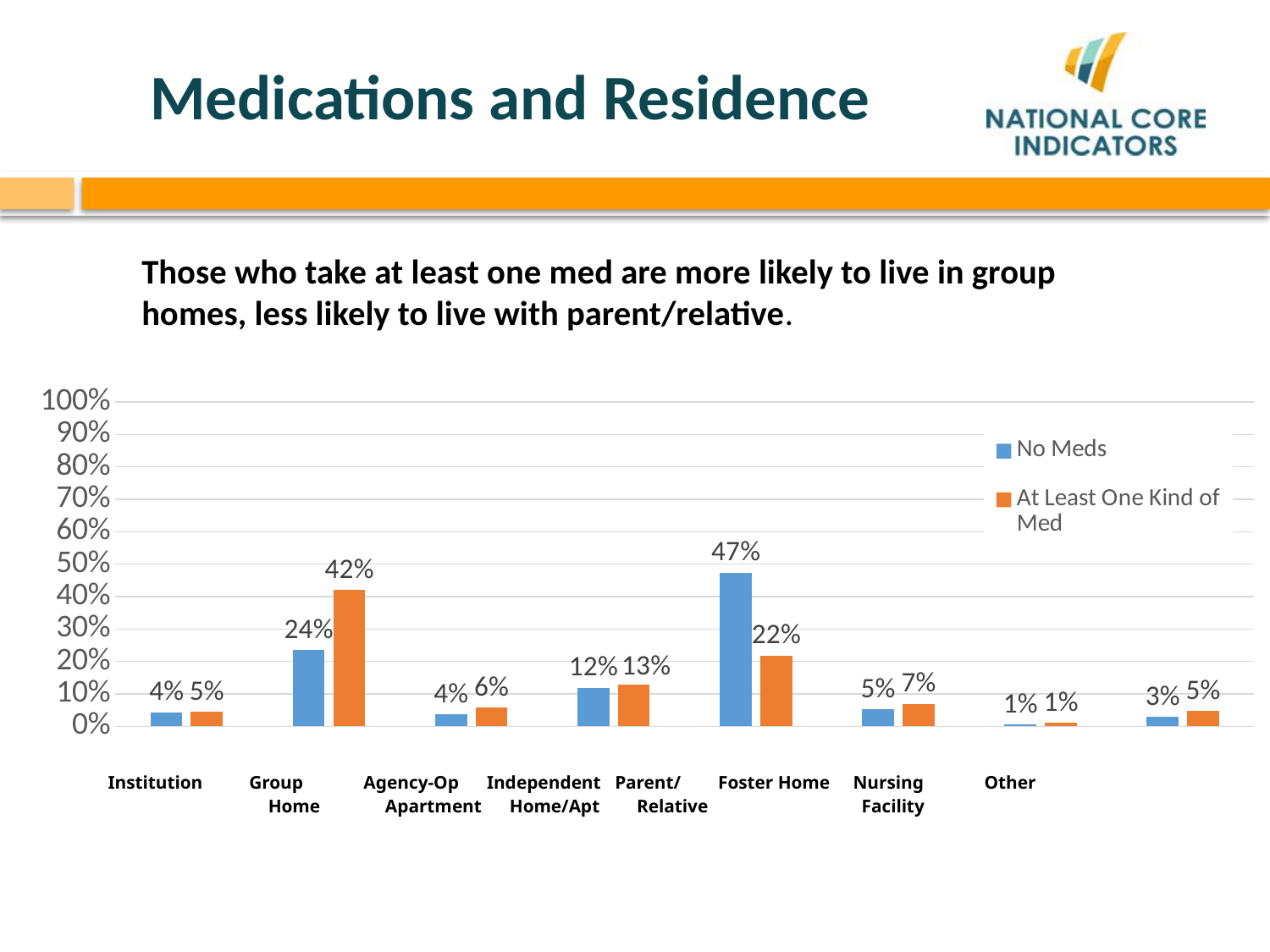
What is the value for At Least One Kind of Med in the Parent/Relative category? 22% What kind of chart is shown on the slide? Bar chart Which category has the highest value for the At Least One Kind of Med series? Group Home How many residence categories are shown on the x axis? 8 Which category has the lowest value for the No Meds series? Nursing Facility How many series does the legend list? 2 What is the difference between the At Least One Kind of Med and No Meds values for Group Home? 18% What is the difference between the No Meds and At Least One Kind of Med values for Parent/Relative? 25% Which category has the highest value for the No Meds series? Parent/Relative What is the value for No Meds in the Group Home category? 24% What is the value for At Least One Kind of Med in the Nursing Facility category? 1% For Foster Home, which series has the larger value, No Meds or At Least One Kind of Med? At Least One Kind of Med